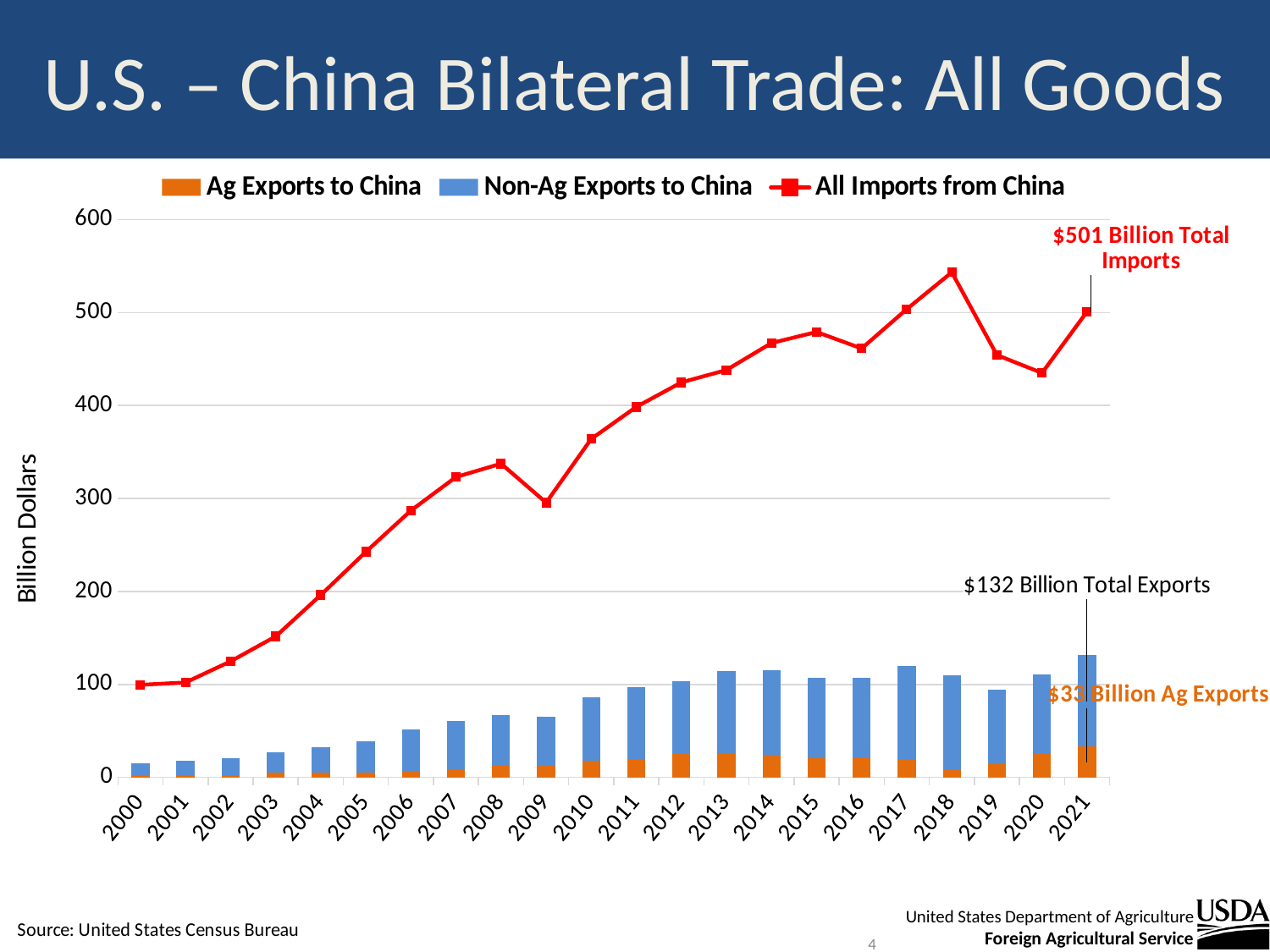
Were all imports from China greater or less than 200 in 2005? greater What is the value of total imports from China in 2021 according to the annotation? $501 Billion How many years are shown along the x axis of the chart? 22 What is the value of ag exports to China in 2021 according to the annotation? $33 Billion In which year were all imports from China highest? 2018 Based on the annotated 2021 values, what were non-ag exports to China in 2021? $99 Billion How many series does the chart legend list? 3 What is the title of the chart on the slide? U.S. – China Bilateral Trade: All Goods What is the value of total exports to China in 2021 according to the annotation? $132 Billion What kind of chart is shown on the slide? Combined bar and line chart Which year had larger all imports from China, 2018 or 2019? 2018 By how much did total imports from China exceed total exports to China in 2021? $369 Billion